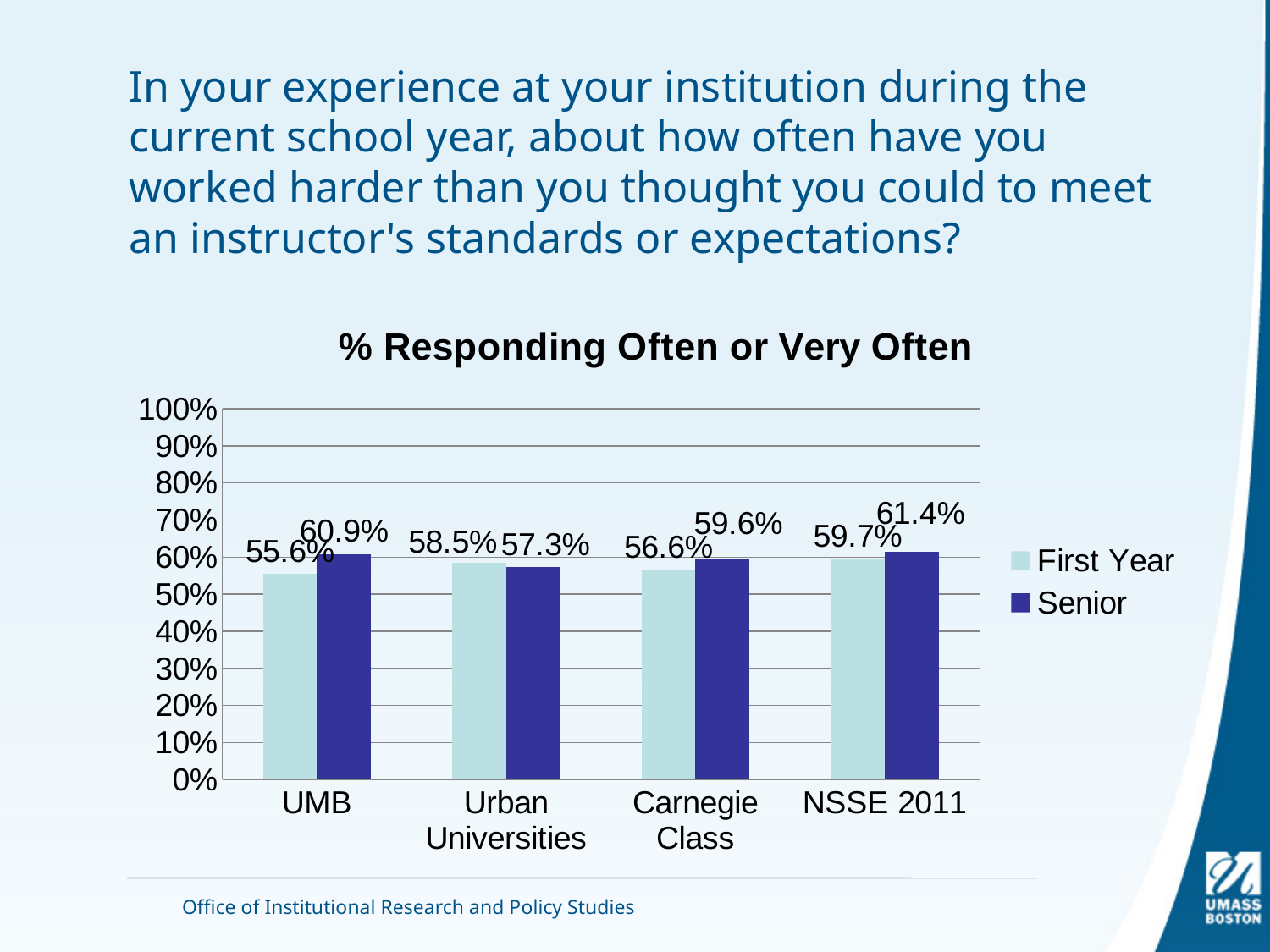
What is the Senior value for NSSE 2011? 61.4% Is the Senior value for Carnegie Class greater or less than 50%? greater How many series does the legend list? 2 What type of chart is shown on the slide? Bar chart Which category has the lowest First Year value? UMB What is the Senior value for Urban Universities? 57.3% What is the First Year value for Carnegie Class? 56.6% Which category has the highest Senior value? NSSE 2011 What is the First Year value for UMB? 55.6% For Urban Universities, which is larger: the First Year value or the Senior value? First Year What is the difference between the Senior and First Year values for UMB? 5.3% How many categories are shown on the x axis? 4